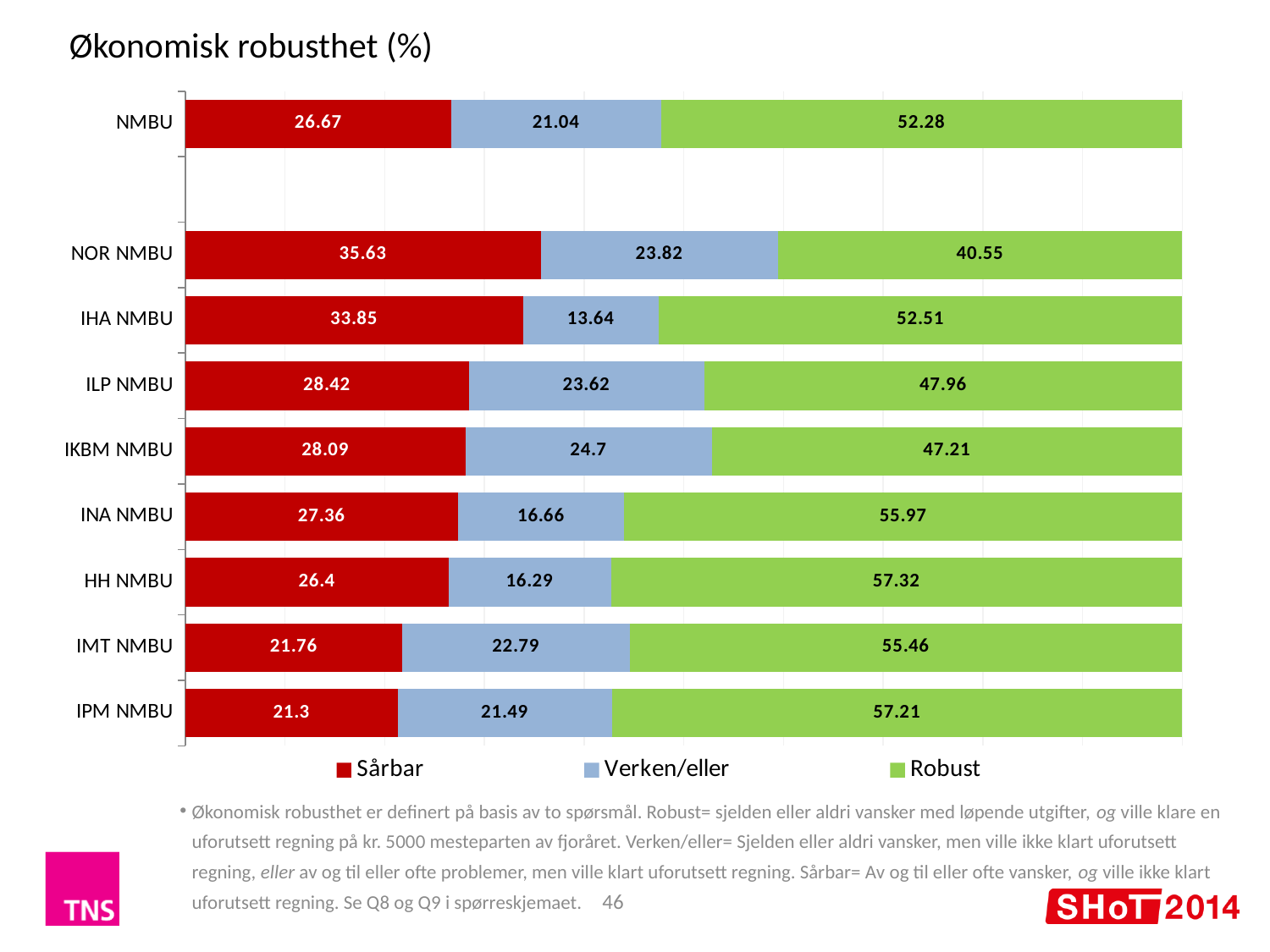
What is the Robust value for HH NMBU? 57.32 What is the Verken/eller value for IHA NMBU? 13.64 Which has the larger Verken/eller value, IMT NMBU or HH NMBU? IMT NMBU Which category has the highest Sårbar value? NOR NMBU What is the difference between the Sårbar values for NOR NMBU and NMBU? 8.96 Which category has the lowest Verken/eller value? IHA NMBU What kind of chart is shown on the slide? Stacked bar chart Which category has the lowest Robust value? NOR NMBU What is the total of the stacked bar for IPM NMBU? 100 How many series does the legend list? 3 How many categories are shown on the chart? 9 What is the Sårbar value for NOR NMBU? 35.63